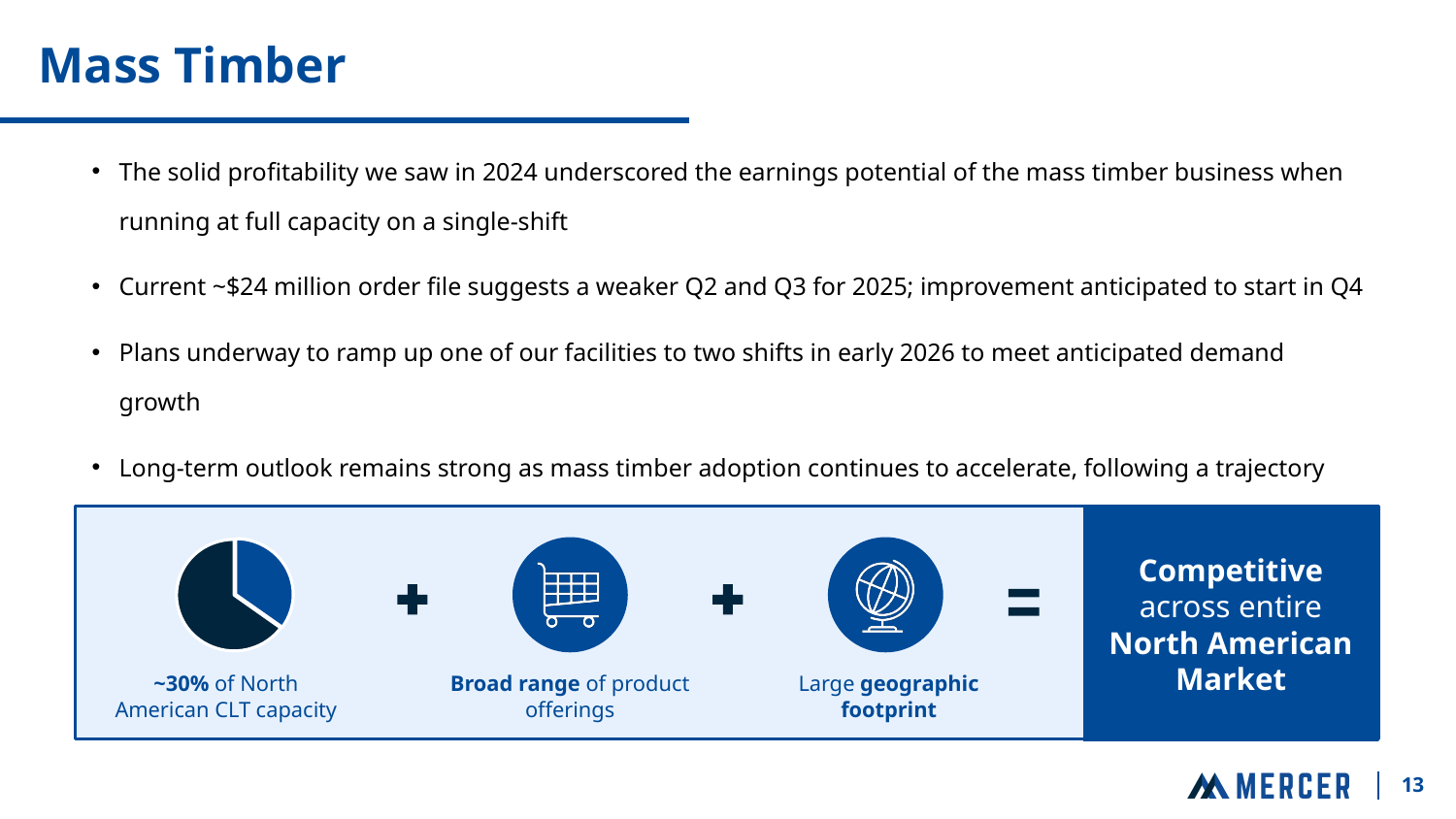
According to the label under the pie chart, what share of North American CLT capacity does the highlighted slice represent? ~30% What kind of chart is shown in the blue box at the bottom left of the slide? pie chart How many slices does the pie chart at the bottom left of the slide have? 2 Is the share shown by the highlighted slice of the pie chart greater or less than 50%? less What is the title of the slide that contains the pie chart? Mass Timber What does the label beneath the pie chart say the chart represents? ~30% of North American CLT capacity In the pie chart at the bottom left, is the highlighted blue slice larger or smaller than the dark remainder of the pie? smaller